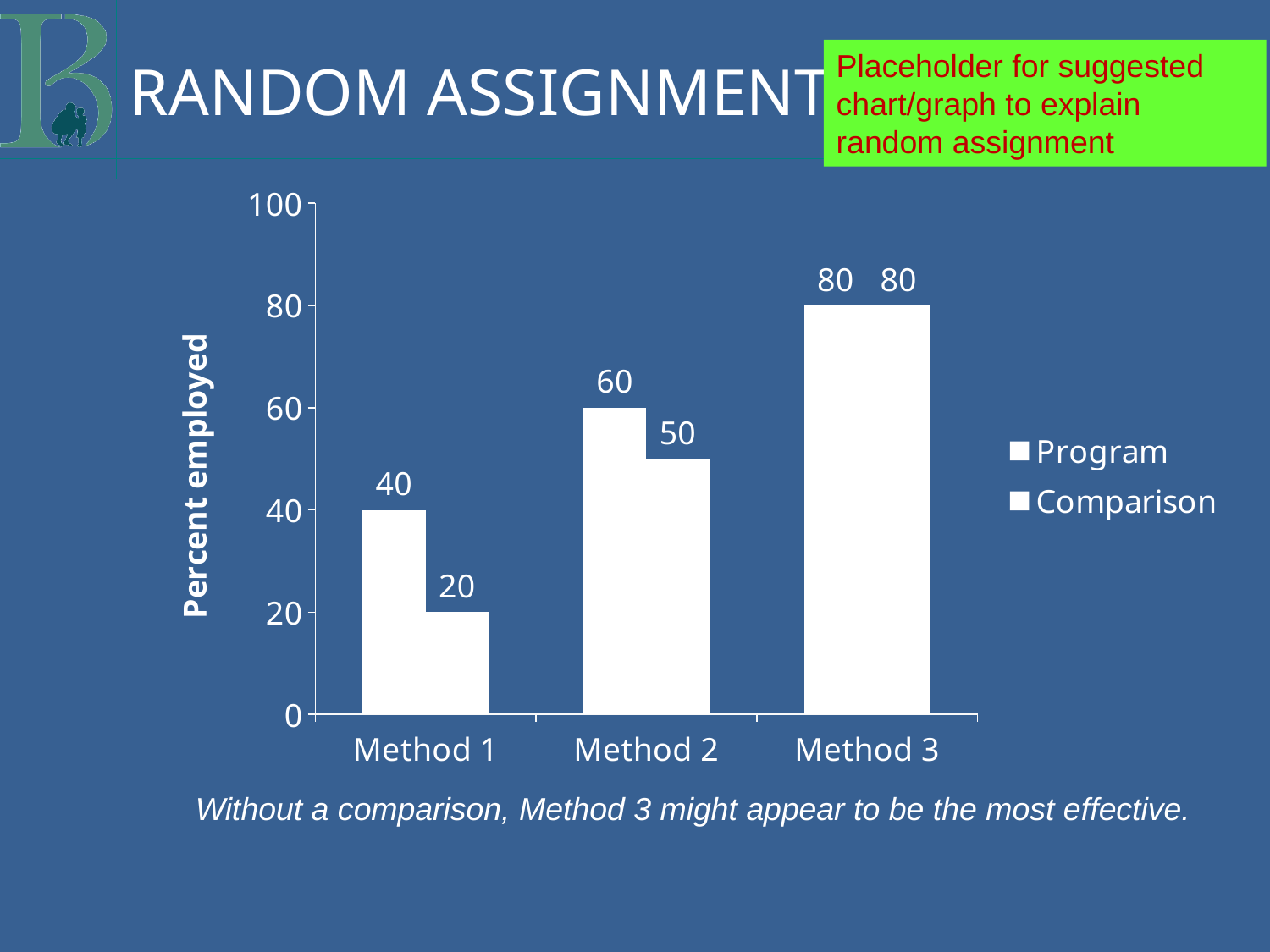
What kind of chart is shown on the slide? Bar chart What is the label of the y axis? Percent employed Which method has the lowest Comparison value? Method 1 Which is larger for Method 2, the Program value or the Comparison value? Program Which method has the highest Program value? Method 3 What is the Comparison value for Method 2? 50 What is the Program value for Method 1? 40 What is the difference between the Program values for Method 3 and Method 2? 20 What is the difference between the Program and Comparison values for Method 1? 20 How many series does the legend list? 2 What is the Comparison value for Method 3? 80 How many methods are shown on the x axis? 3